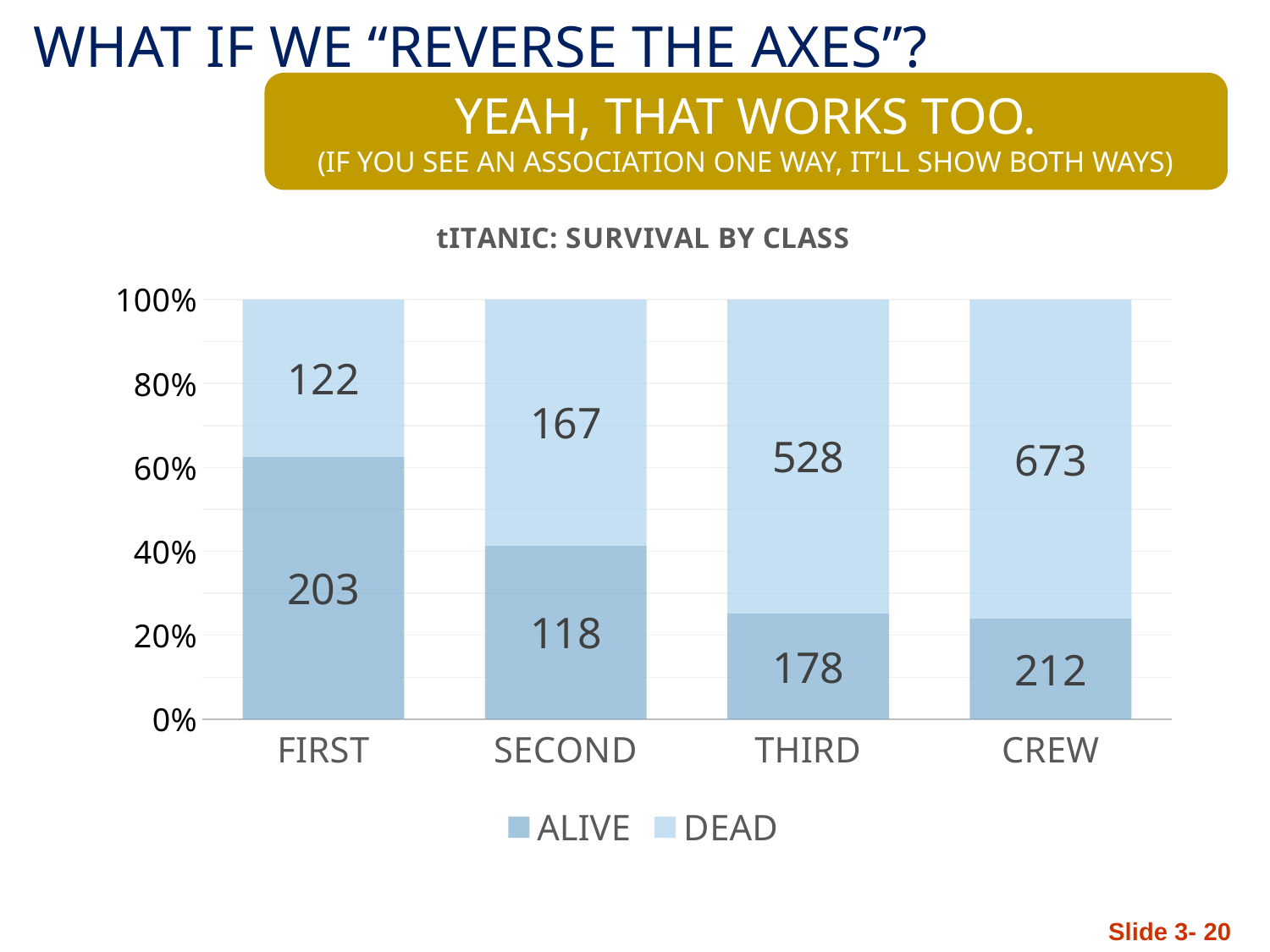
What is the ALIVE value for FIRST class? 203 What is the difference between the DEAD and ALIVE values for THIRD class? 350 Which class has the lowest ALIVE value? SECOND How many classes are shown on the x axis? 4 What is the title of the chart? tITANIC: SURVIVAL BY CLASS What is the DEAD value for CREW? 673 What is the total of the ALIVE and DEAD values for FIRST class? 325 What type of chart is shown on the slide? stacked bar chart How many series does the legend list? 2 Which class has the highest DEAD value? CREW Is the ALIVE share of the THIRD class bar greater or less than 20%? greater What is the DEAD value for SECOND class? 167